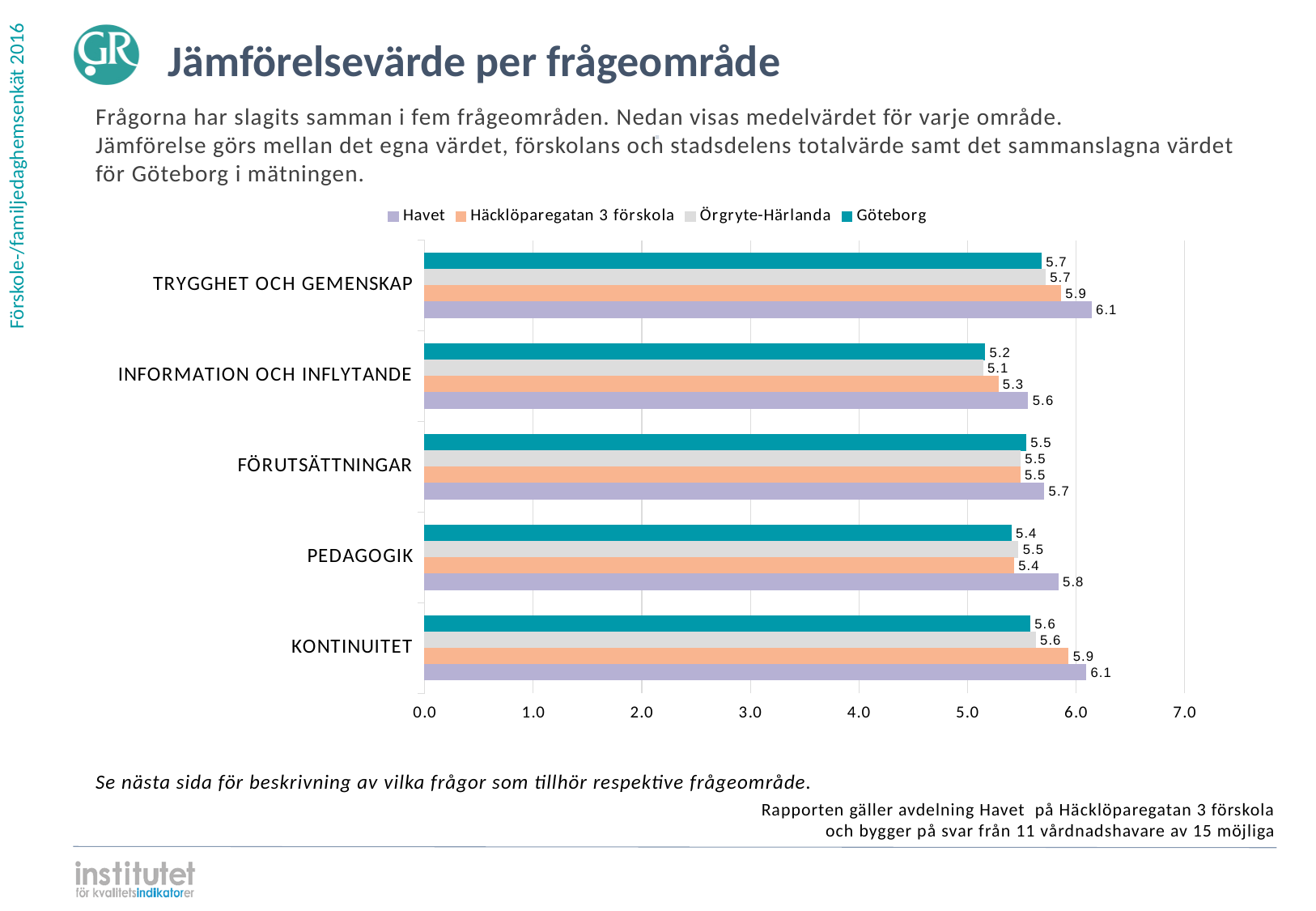
What is the value for Örgryte-Härlanda in the category TRYGGHET OCH GEMENSKAP? 5.7 How many series does the legend list? 4 Which is larger in the category INFORMATION OCH INFLYTANDE: the value for Häcklöparegatan 3 förskola or the value for Örgryte-Härlanda? Häcklöparegatan 3 förskola What is the difference between the Havet value and the Göteborg value in the category PEDAGOGIK? 0.4 What is the value for Göteborg in the category PEDAGOGIK? 5.4 What is the value for Havet in the category INFORMATION OCH INFLYTANDE? 5.6 Which series is shown in purple in the legend? Havet How many question areas (categories) are shown on the chart? 5 What is the value for Häcklöparegatan 3 förskola in the category KONTINUITET? 5.9 What type of chart is shown on the slide? bar chart Is the value for Havet in the category KONTINUITET greater or less than 6.0? greater In which category does Havet have its lowest value? INFORMATION OCH INFLYTANDE